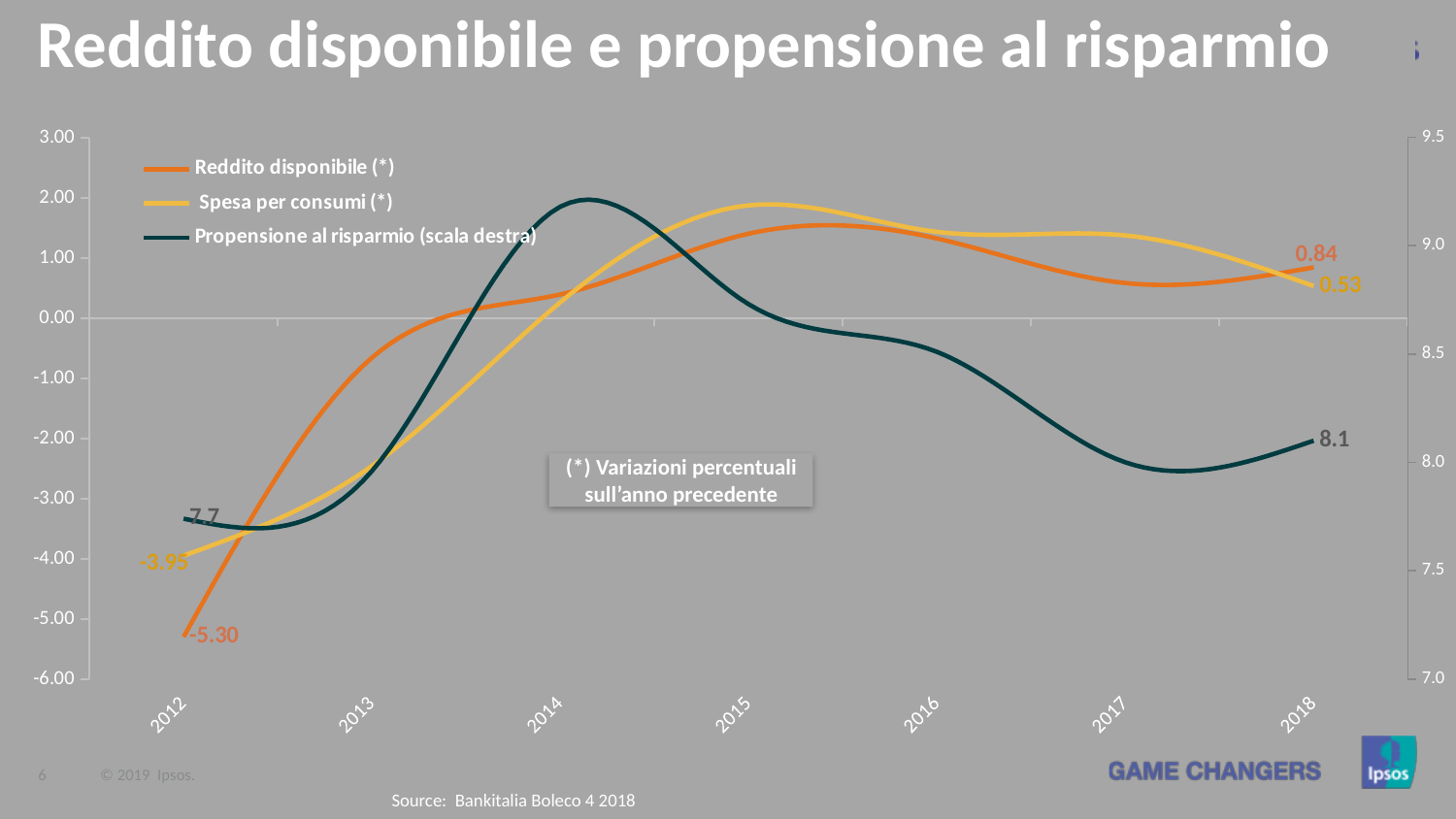
What is the value of Spesa per consumi (*) in 2012? -3.95 How many series does the legend list? 3 Is the value for Reddito disponibile (*) in 2015 greater or less than 1.00? greater What kind of chart is shown on the slide? line chart What is the value of Spesa per consumi (*) in 2018? 0.53 What is the value of Propensione al risparmio (scala destra) in 2012? 7.7 What is the value of Reddito disponibile (*) in 2012? -5.30 By how much did Reddito disponibile (*) change from 2012 to 2018? 6.14 How many years are shown on the x axis? 7 What is the value of Propensione al risparmio (scala destra) in 2018? 8.1 In 2018, which is larger: Reddito disponibile (*) or Spesa per consumi (*)? Reddito disponibile (*) What is the value of Reddito disponibile (*) in 2018? 0.84